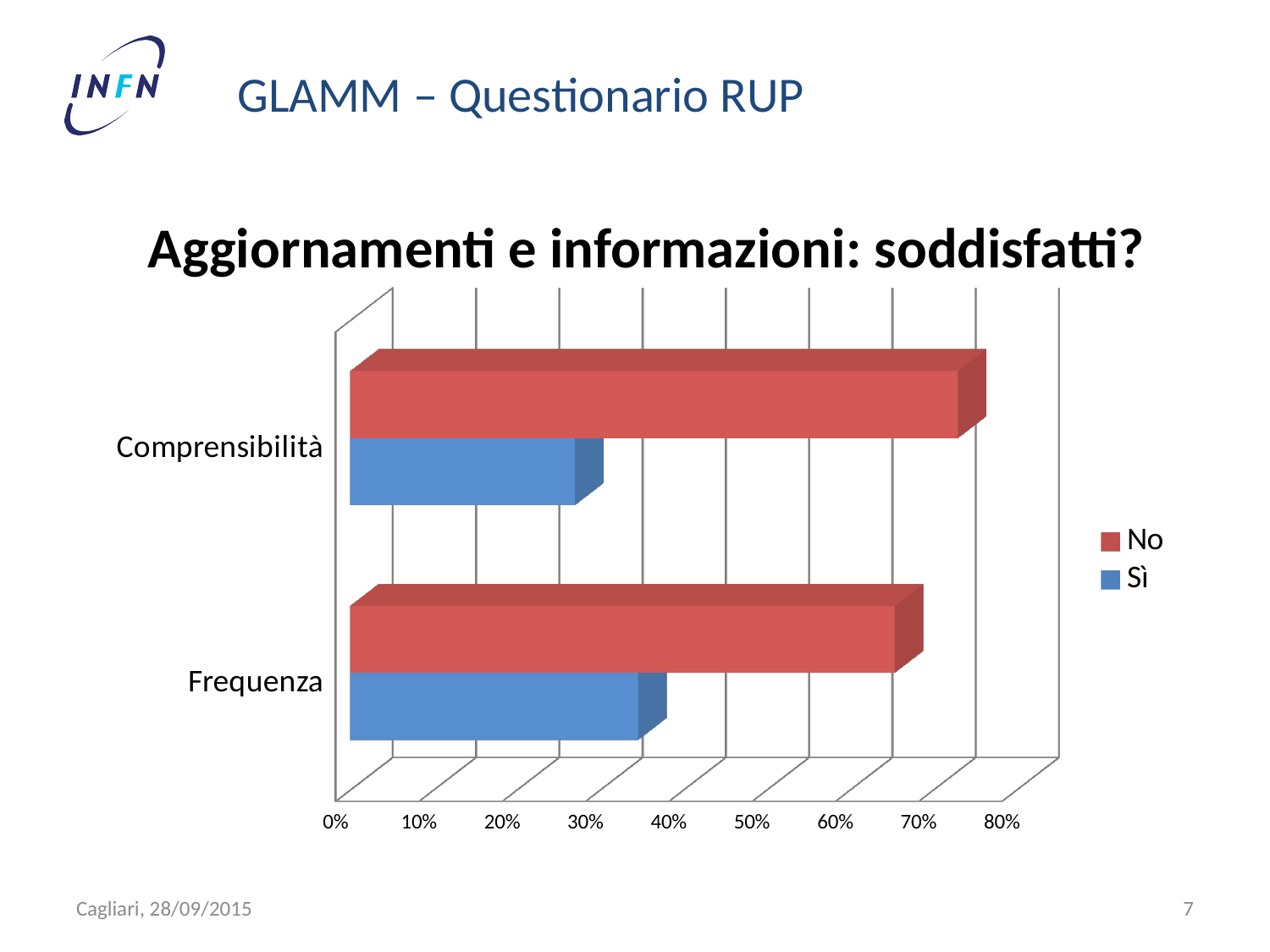
How many series does the legend list? 2 Is the 'No' value for Frequenza greater or less than 50%? greater Which series is shown in red? No How many categories are shown on the vertical axis? 2 For Frequenza, which is larger, the 'No' value or the 'Sì' value? No Is the 'Sì' value for Comprensibilità greater or less than 40%? less Which category has the higher 'No' value, Comprensibilità or Frequenza? Comprensibilità What kind of chart is shown on the slide? bar chart Is the 'Sì' value for Frequenza greater or less than 50%? less Which category has the higher 'Sì' value, Comprensibilità or Frequenza? Frequenza What is the title of the chart? Aggiornamenti e informazioni: soddisfatti?